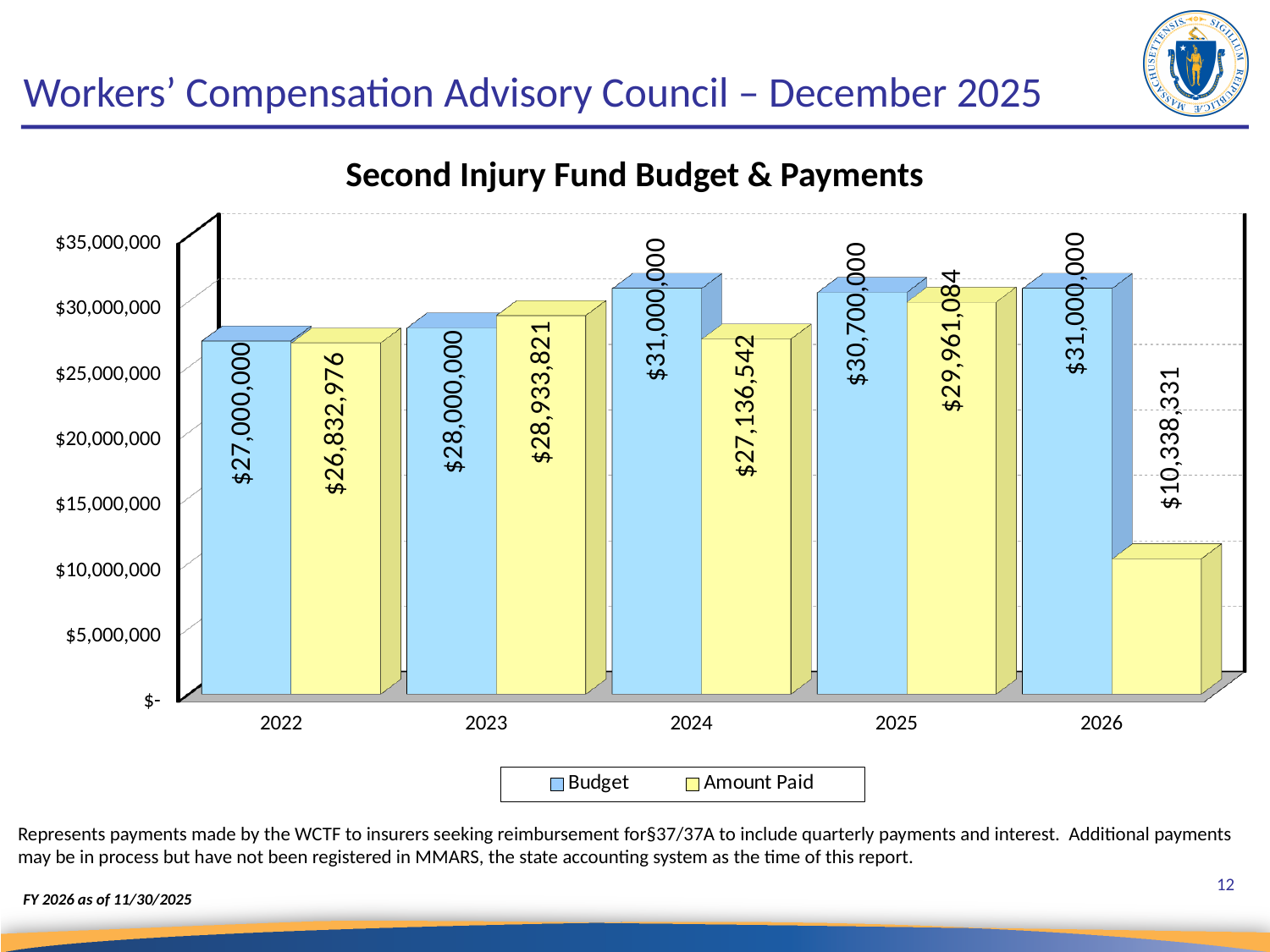
Which year has the lowest Budget? 2022 What is the Budget value for 2024? $31,000,000 Which year has the lowest Amount Paid? 2026 What is the Amount Paid for 2026? $10,338,331 How many series does the legend list? 2 What type of chart is shown on the slide? Bar chart Which year has the highest Amount Paid? 2025 What is the difference between the Budget and the Amount Paid in 2024? $3,863,458 How many years are shown on the x axis? 5 In 2023, which is larger, the Budget or the Amount Paid? Amount Paid What is the Budget value for 2025? $30,700,000 What is the Amount Paid for 2023? $28,933,821